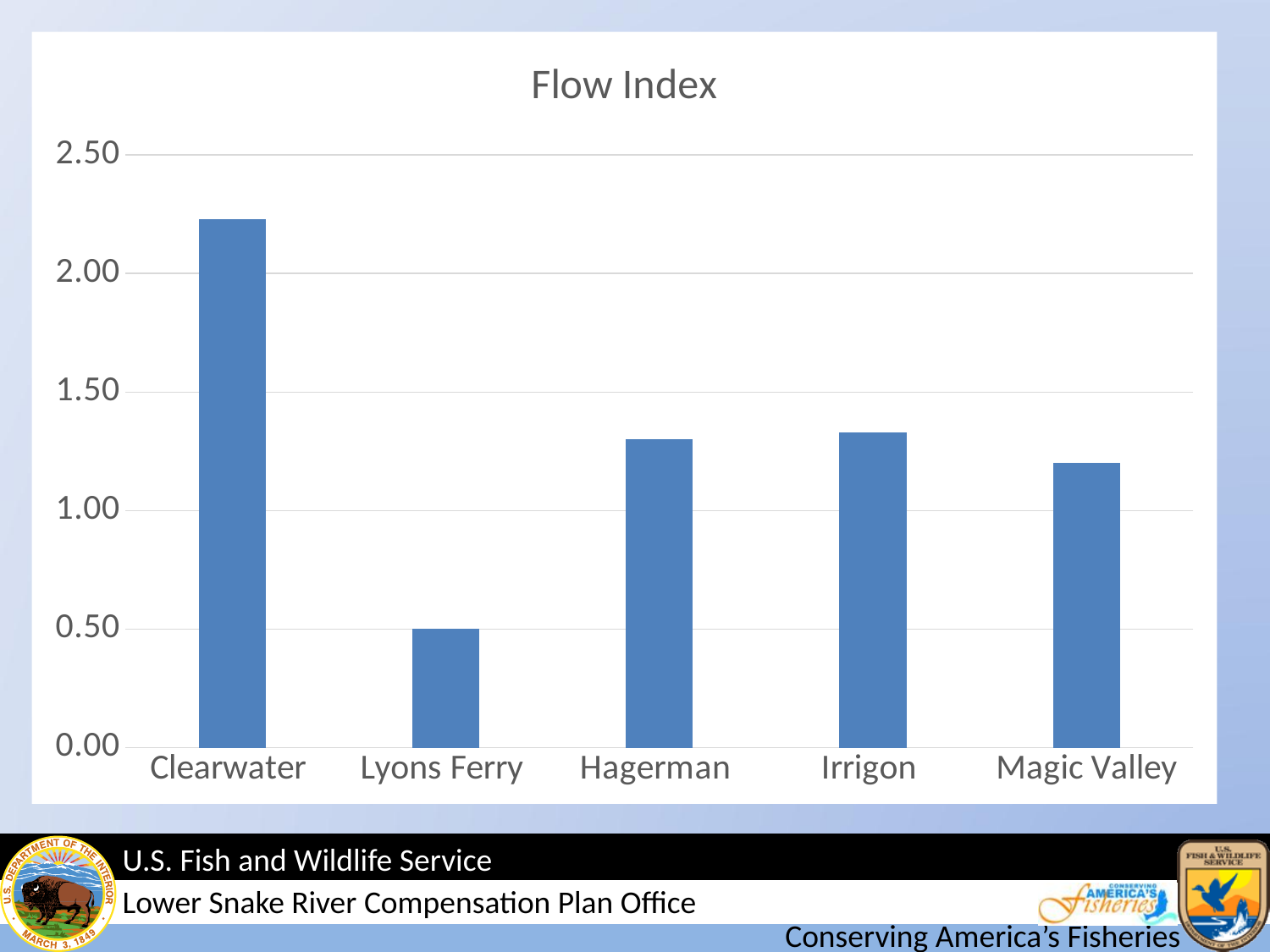
Which category has the lowest Flow Index? Lyons Ferry Is the Flow Index for Magic Valley greater or less than 1.50? less What is the title of the chart? Flow Index How many categories are shown on the x axis of the Flow Index chart? 5 Which has a higher Flow Index, Clearwater or Irrigon? Clearwater Is the Flow Index for Irrigon greater or less than 1.50? less What kind of chart is shown on the slide? bar chart Which has a higher Flow Index, Magic Valley or Lyons Ferry? Magic Valley Which category has the highest Flow Index? Clearwater Is the Flow Index for Hagerman greater or less than 1.00? greater What is the highest value labelled on the y axis of the chart? 2.50